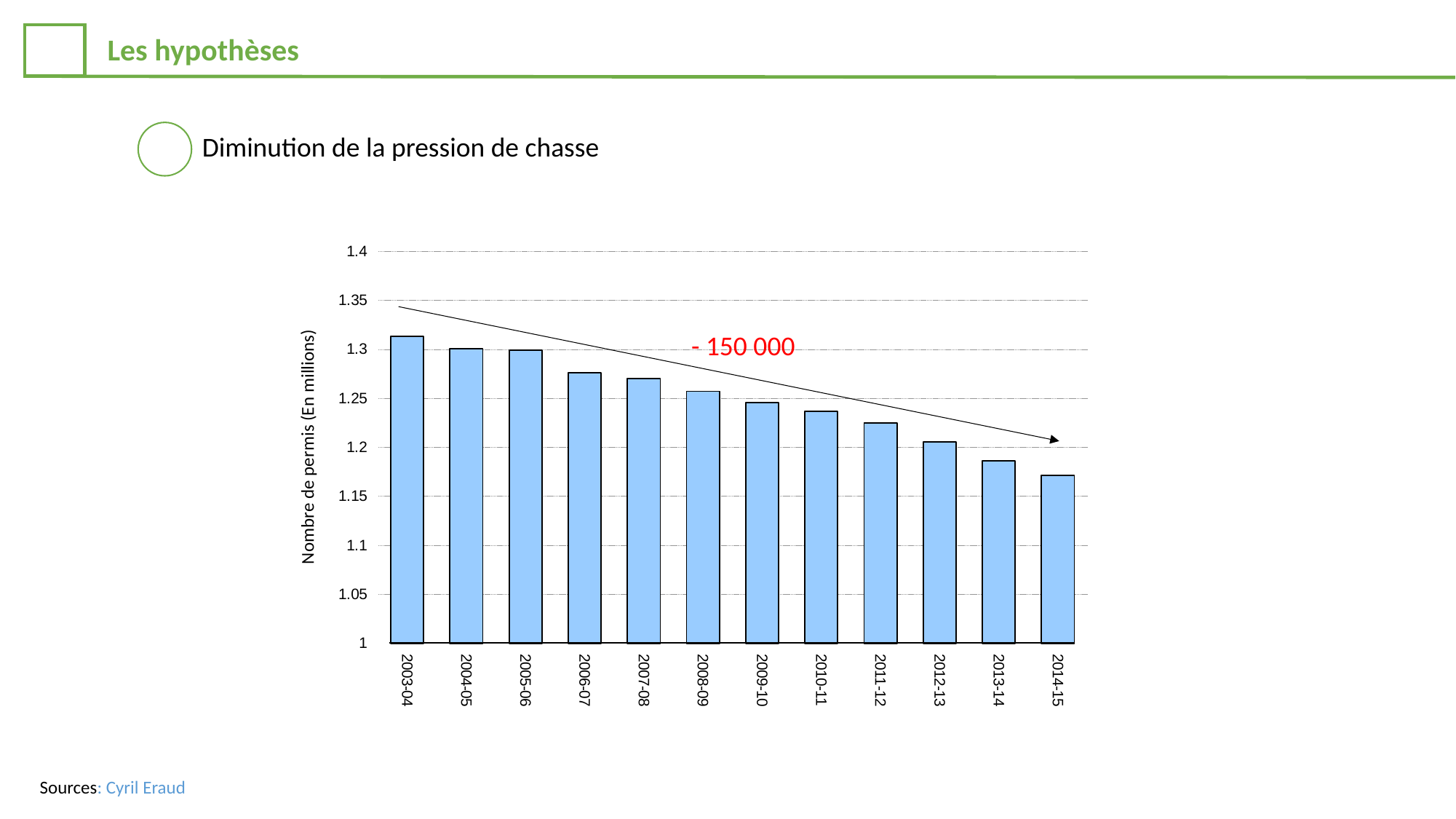
Do the values in the chart rise or fall from 2003-04 to 2014-15? fall Is the value for 2014-15 greater or less than 1.2? less How many hunting seasons (categories) are shown on the x axis of the chart? 12 What is the label of the vertical axis of the chart? Nombre de permis (En millions) Which season has the lowest number of permits in the chart? 2014-15 Which is larger, the value for 2006-07 or the value for 2012-13? 2006-07 Is the value for 2003-04 greater or less than 1.3? greater What kind of chart is shown on the slide? bar chart What text is written in red next to the arrow on the chart? - 150 000 Is the value for 2006-07 greater or less than 1.25? greater Which season has the highest number of permits in the chart? 2003-04